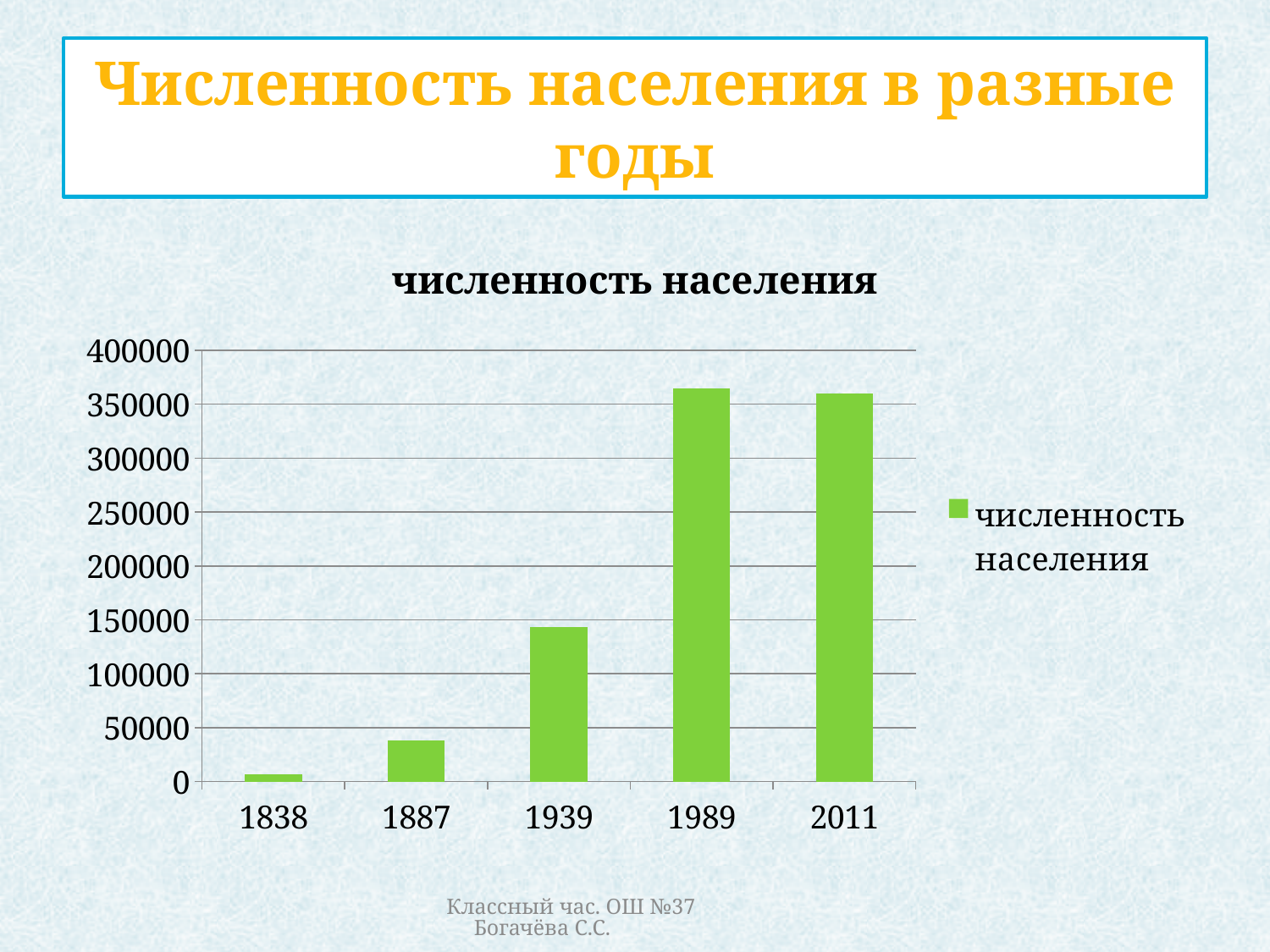
What colour are the bars in the chart? green Do the values rise or fall from 1838 to 1989? rise Which is larger, the value for 1887 or the value for 1939? 1939 What kind of chart is shown on the slide? bar chart Which year has the lowest population value in the chart? 1838 What is the title of the chart? численность населения Is the value for 2011 greater or less than 300000? greater Is the value for 1939 greater or less than 150000? less Is the value for 1989 greater or less than 350000? greater How many years are shown on the x axis of the chart? 5 How many series does the chart legend list? 1